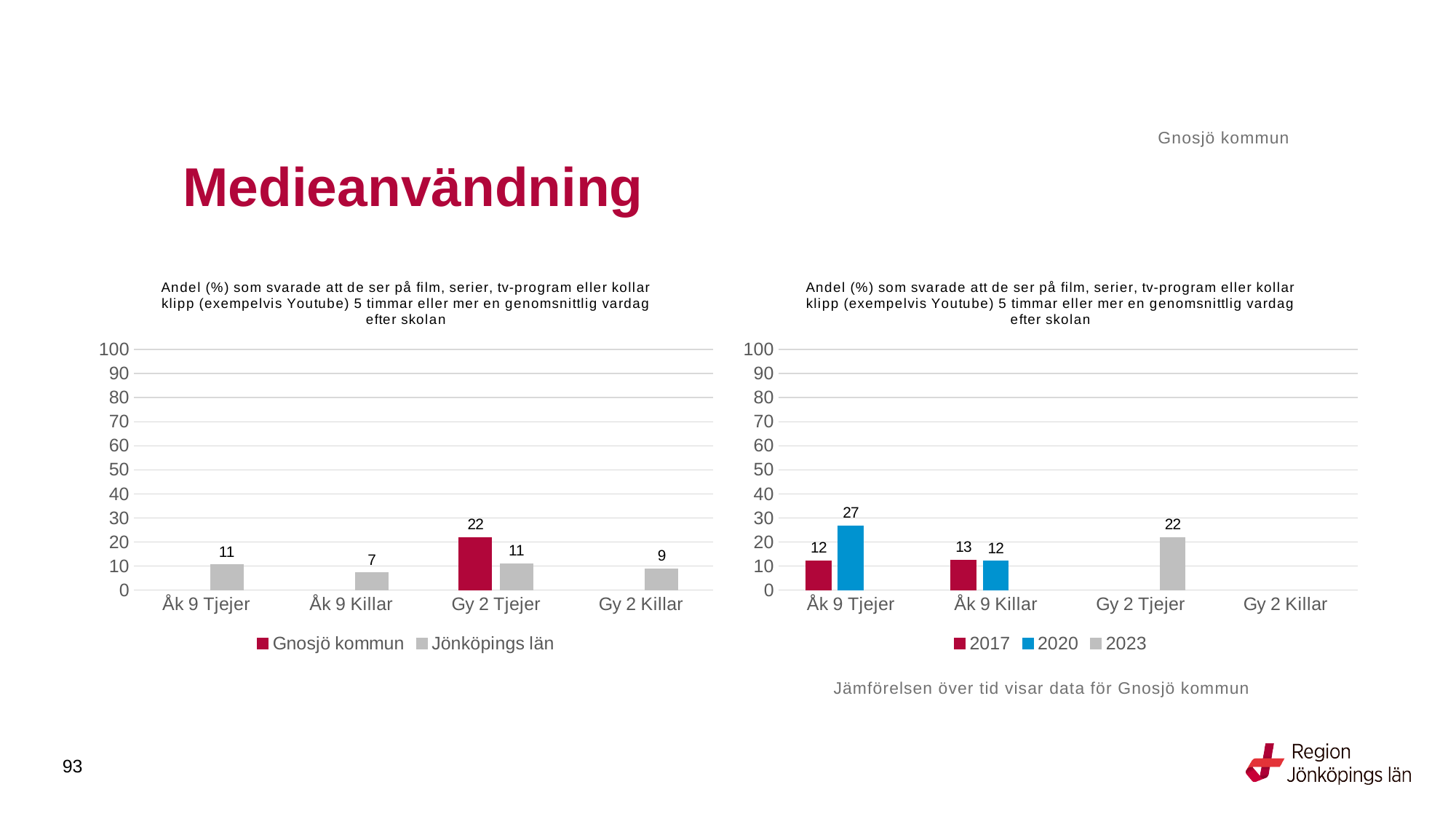
In the right chart, which is larger for Åk 9 Tjejer: 2017 or 2020? 2020 In the left chart, what is the difference between Gnosjö kommun and Jönköpings län for Gy 2 Tjejer? 11 In the left chart, how many series does the legend list? 2 In the left chart, what is the value for Gnosjö kommun for Gy 2 Tjejer? 22 In the right chart, how many series does the legend list? 3 What kind of chart is the left chart? Bar chart In the right chart, what is the value for 2020 for Åk 9 Tjejer? 27 In the right chart, what is the value for 2023 for Gy 2 Tjejer? 22 In the right chart, what is the difference between the 2020 and 2017 values for Åk 9 Tjejer? 15 In the left chart, which category has the lowest value for Jönköpings län? Åk 9 Killar In the left chart, what is the value for Jönköpings län for Åk 9 Killar? 7 In the right chart, what is the value for 2017 for Åk 9 Killar? 13